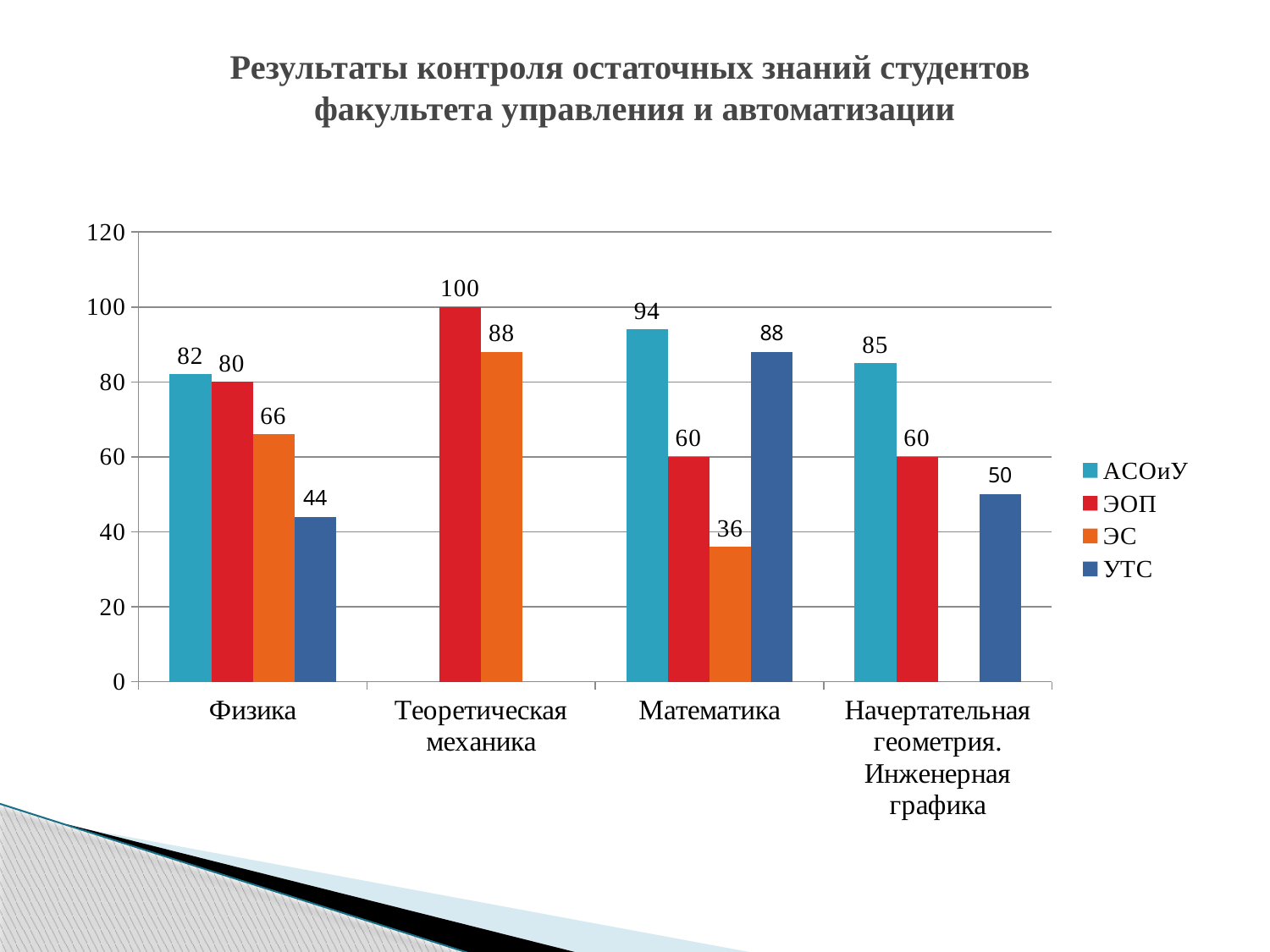
What is the difference between the АСОиУ and УТС values in Физика? 38 Which colour represents the ЭС series in the legend? Orange What is the value for ЭОП in Теоретическая механика? 100 How many series does the legend list? 4 How many categories are shown on the x axis? 4 What kind of chart is shown on the slide? Bar chart Which series has the highest value in Физика? АСОиУ What is the value for АСОиУ in Физика? 82 What is the value for ЭС in Математика? 36 Which series has the lowest value in Математика? ЭС Which is larger in Математика: the АСОиУ value or the УТС value? АСОиУ What is the value for УТС in Начертательная геометрия. Инженерная графика? 50